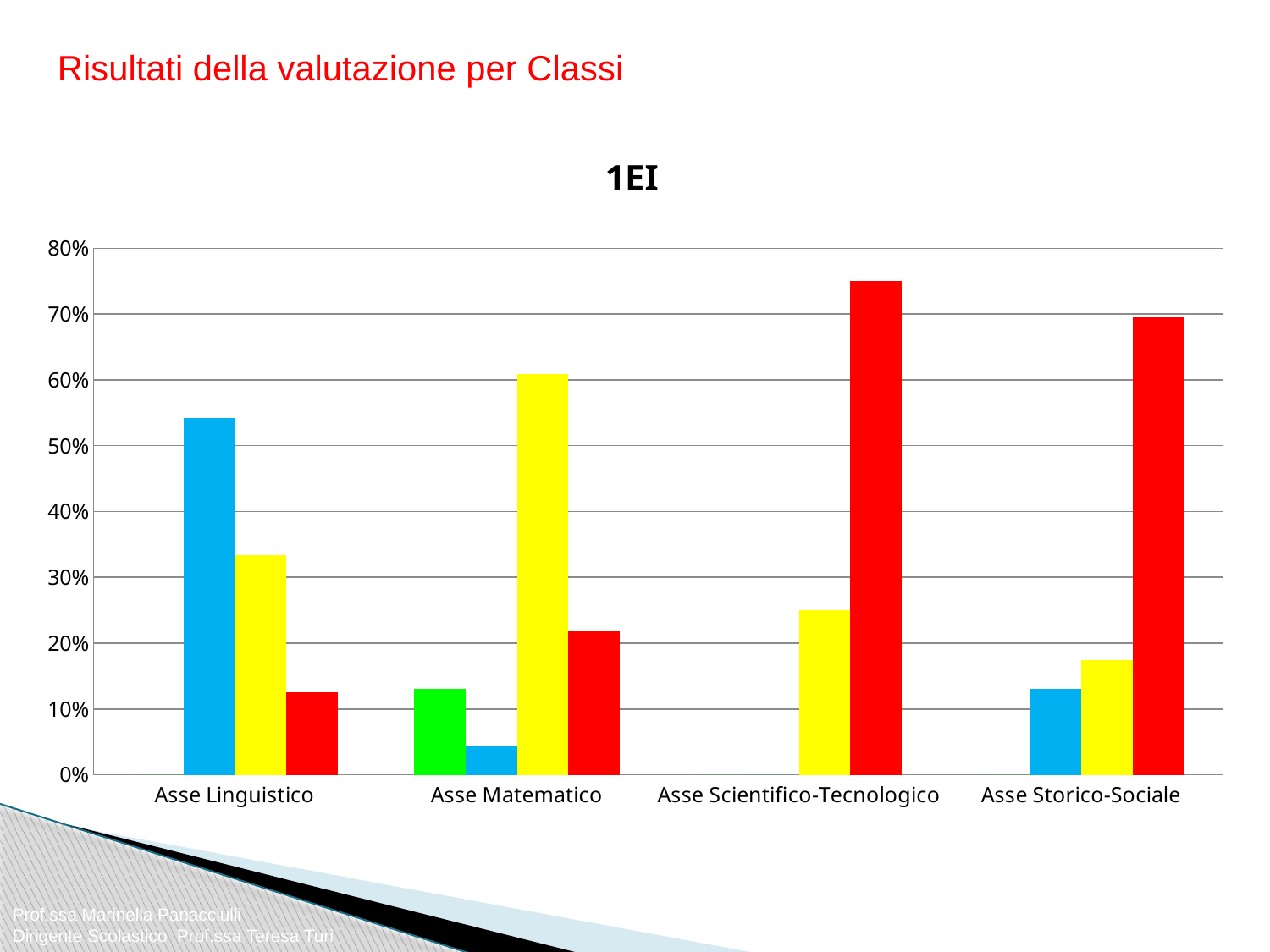
Is the value of the blue bar for Asse Linguistico greater or less than 50%? greater Which category contains the tallest bar in the chart? Asse Scientifico-Tecnologico How many categories are shown on the x axis of the chart? 4 How many bars are shown for the Asse Scientifico-Tecnologico category? 2 Which is larger: the red bar for Asse Scientifico-Tecnologico or the red bar for Asse Storico-Sociale? Asse Scientifico-Tecnologico Which colour bar is the tallest in the Asse Matematico category? yellow What kind of chart is shown on the slide? bar chart Is the value of the yellow bar for Asse Scientifico-Tecnologico greater or less than 20%? greater Is the value of the blue bar for Asse Matematico greater or less than 10%? less Which colour bar is the tallest in the Asse Linguistico category? blue What is the title of the chart? 1EI